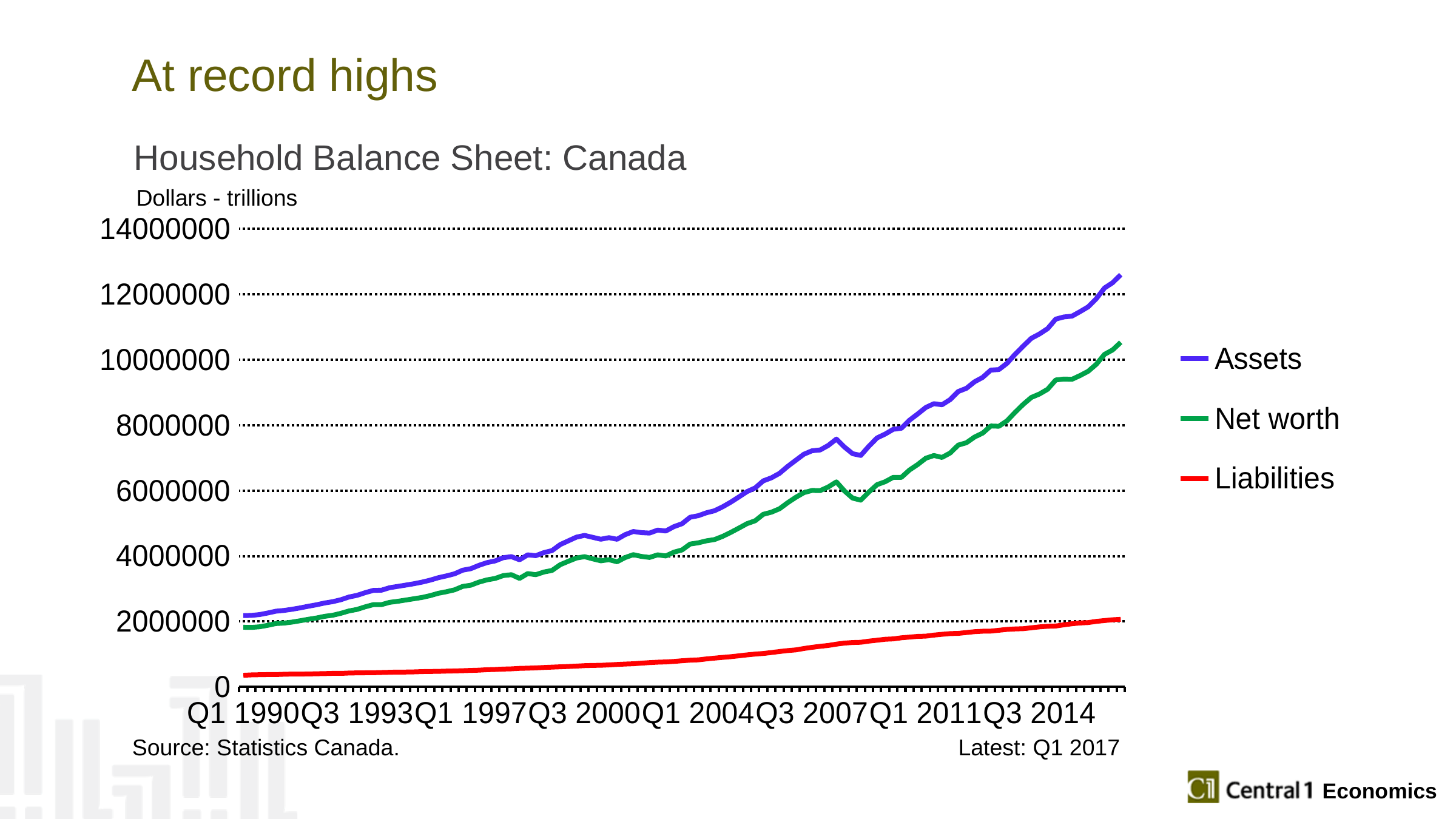
How many series does the legend list? 3 Is the value for Net worth at the end of the chart greater or less than 10000000? greater Is the value for Liabilities at Q1 1990 greater or less than 2000000? less At Q1 2011, which is larger, Net worth or Liabilities? Net worth Do the Assets values rise or fall from Q1 1990 to the end of the chart? rise Which series is plotted lowest across the whole chart? Liabilities What kind of chart is shown on the slide? line chart Which series is plotted highest across the whole chart? Assets Is the value for Assets at Q3 2007 greater or less than 6000000? greater What unit is shown on the chart's vertical axis label? Dollars - trillions What is the title of the chart? Household Balance Sheet: Canada